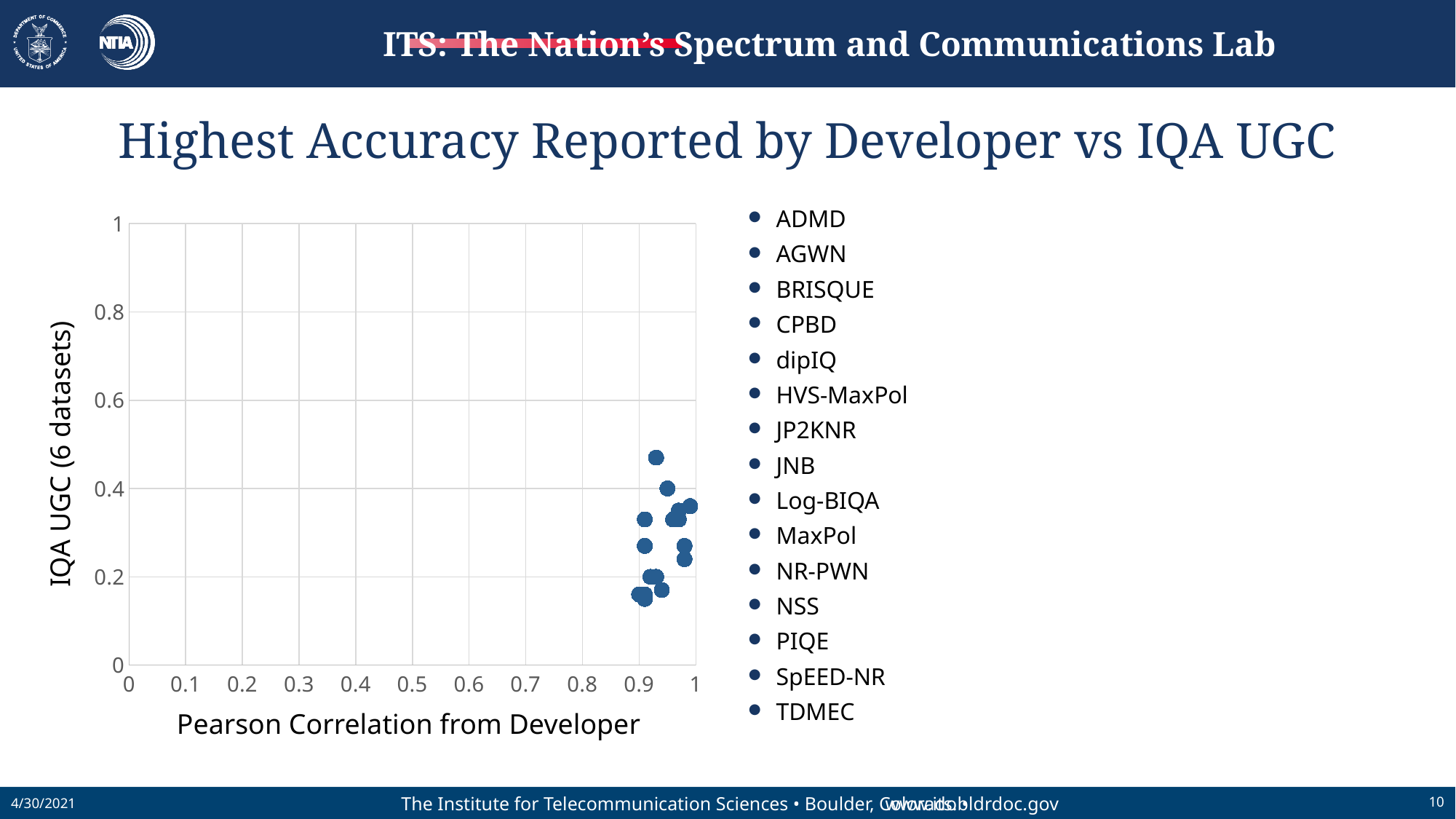
Is the lowest IQA UGC value among the plotted points greater or less than 0.2? less Is the highest IQA UGC value among the plotted points greater or less than 0.5? less Is the Pearson Correlation from Developer value for every plotted point greater or less than 0.8? greater What is the title of the y axis? IQA UGC (6 datasets) What is the title of the x axis? Pearson Correlation from Developer What kind of chart is shown on the slide? scatter chart